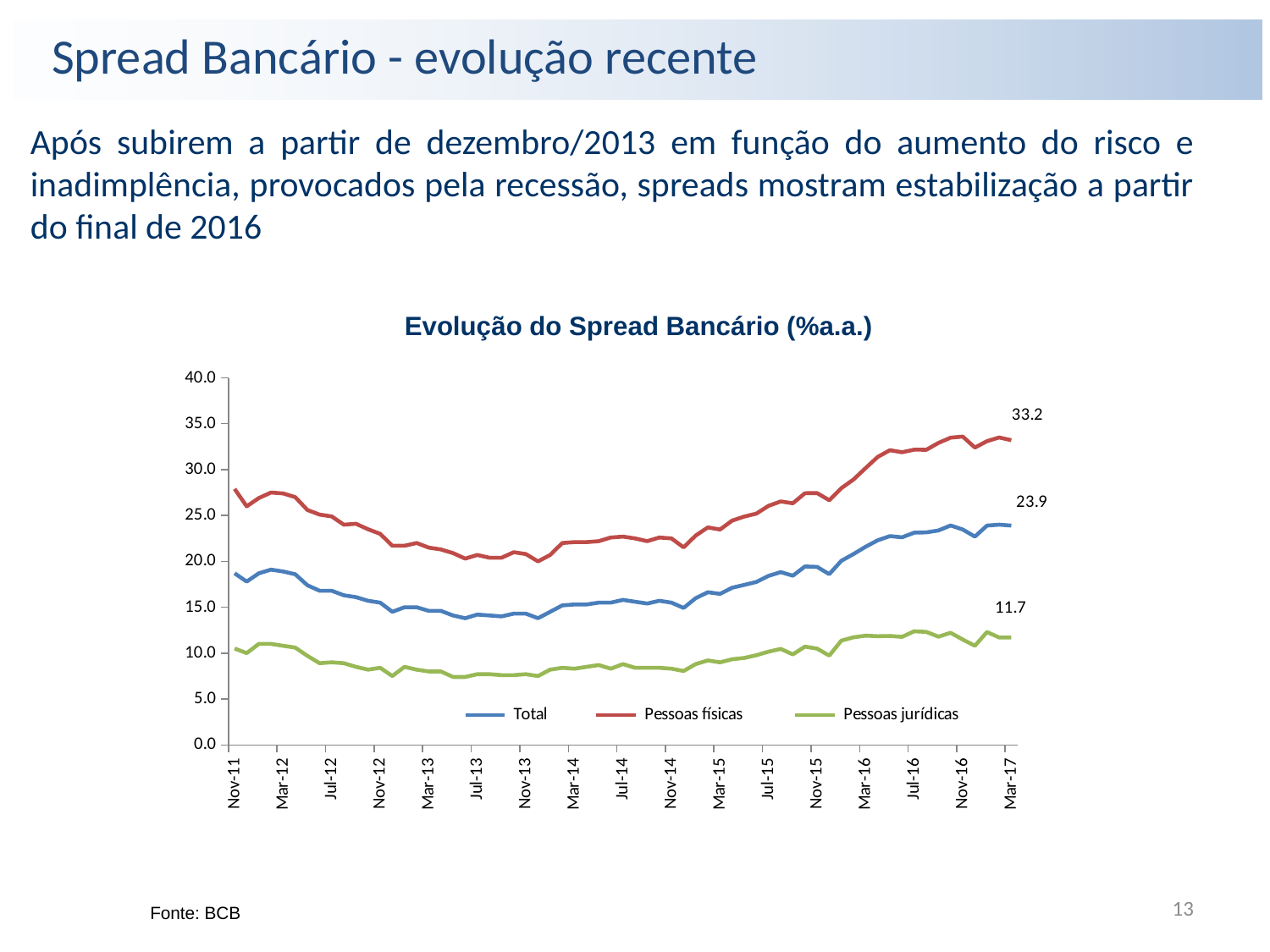
Is the value of the Pessoas físicas series at Jul-13 greater or less than 25.0? less What kind of chart is shown on the slide? Line chart Which series has the highest value at Mar-17? Pessoas físicas What is the value of the Total series at Mar-17? 23.9 How many series does the legend list? 3 What is the difference between the Total and Pessoas jurídicas values at Mar-17? 12.2 At Mar-17, which is larger: the Pessoas físicas value or the Total value? Pessoas físicas What is the difference between the Pessoas físicas and Total values at Mar-17? 9.3 Which series has the lowest value at Mar-17? Pessoas jurídicas What is the value of the Pessoas jurídicas series at Mar-17? 11.7 Is the value of the Total series at Nov-11 greater or less than 15.0? greater What is the value of the Pessoas físicas series at Mar-17? 33.2